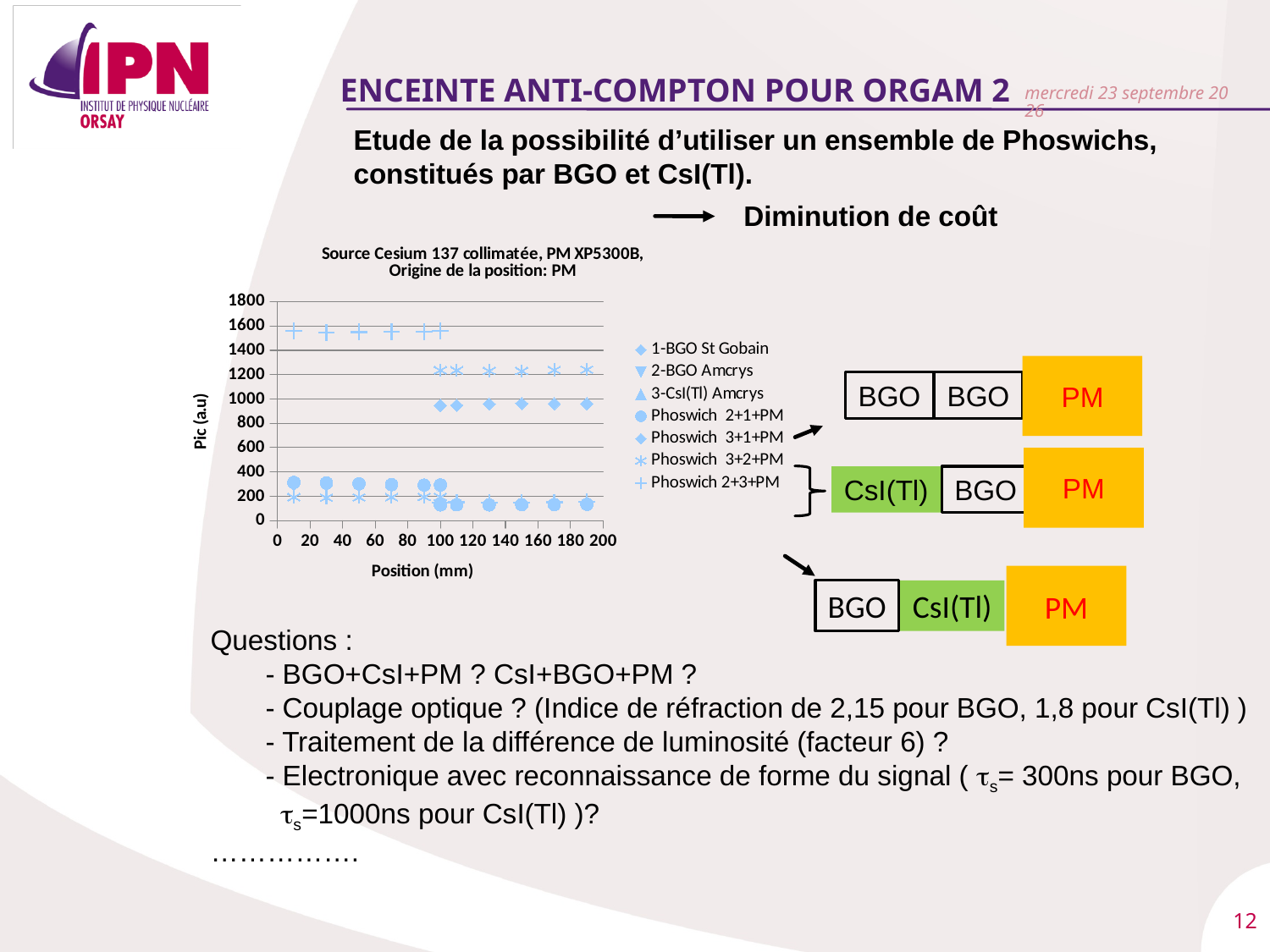
What is the title of the x axis of the chart? Position (mm) What kind of chart is shown on the slide? Scatter chart How many series does the chart legend list? 7 What is the title of the y axis of the chart? Pic (a.u) Are the values for Phoswich 3+2+PM greater or less than 1400? less Are the values for Phoswich 2+1+PM greater or less than 400? less